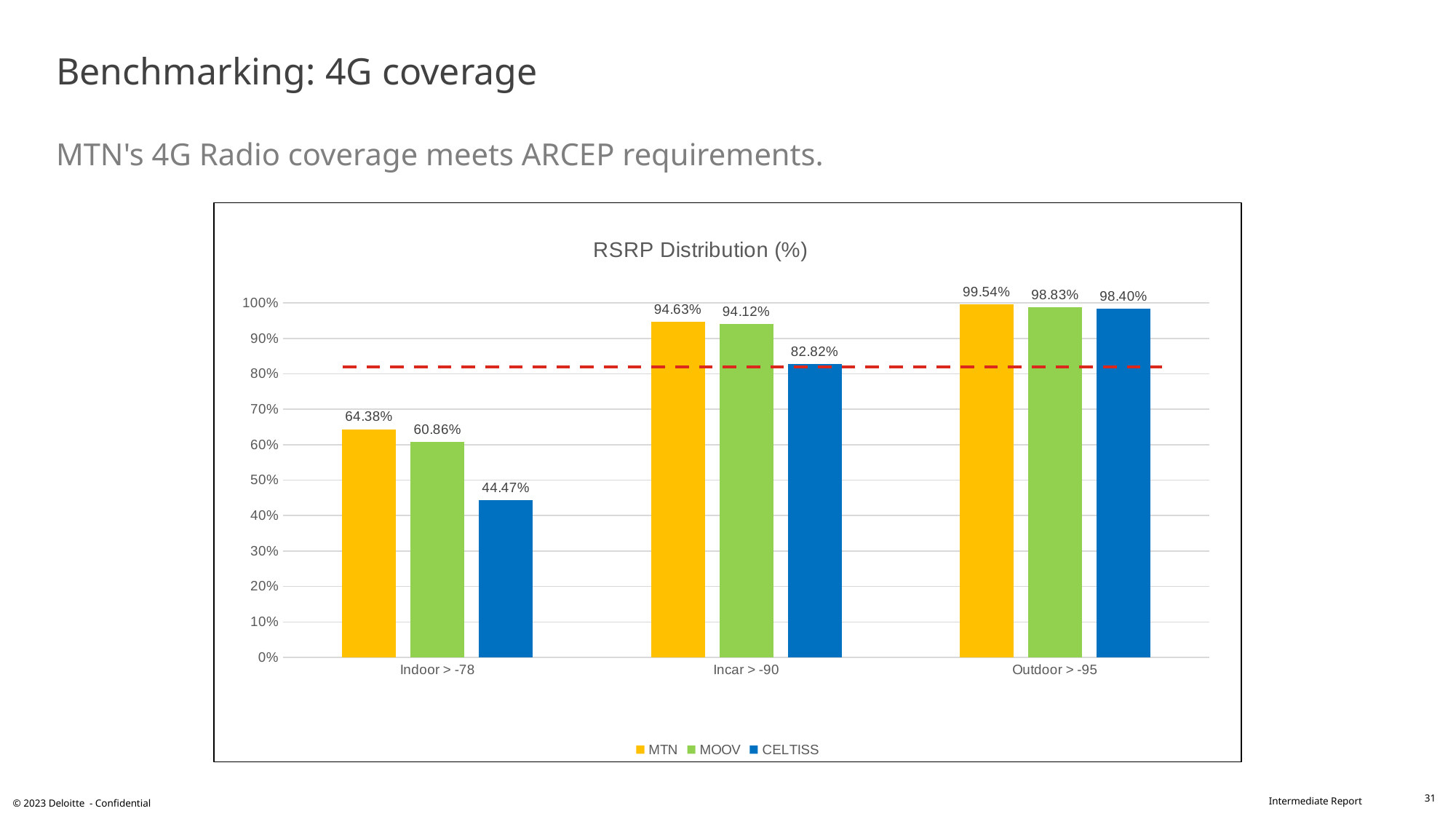
What is the value for MTN in the Indoor > -78 category? 64.38% Which operator has the highest value in the Outdoor > -95 category? MTN Which is larger: MTN in Incar > -90 or MOOV in Incar > -90? MTN in Incar > -90 How many series does the legend list? 3 Which operator has the lowest value in the Indoor > -78 category? CELTISS What is the title of the chart? RSRP Distribution (%) How many categories are shown on the x axis? 3 What is the difference between MOOV and CELTISS in the Incar > -90 category? 11.30% What is the value for MOOV in the Outdoor > -95 category? 98.83% What is the value for CELTISS in the Incar > -90 category? 82.82% What is the difference between MTN and CELTISS in the Indoor > -78 category? 19.91% What kind of chart is shown on the slide? Bar chart